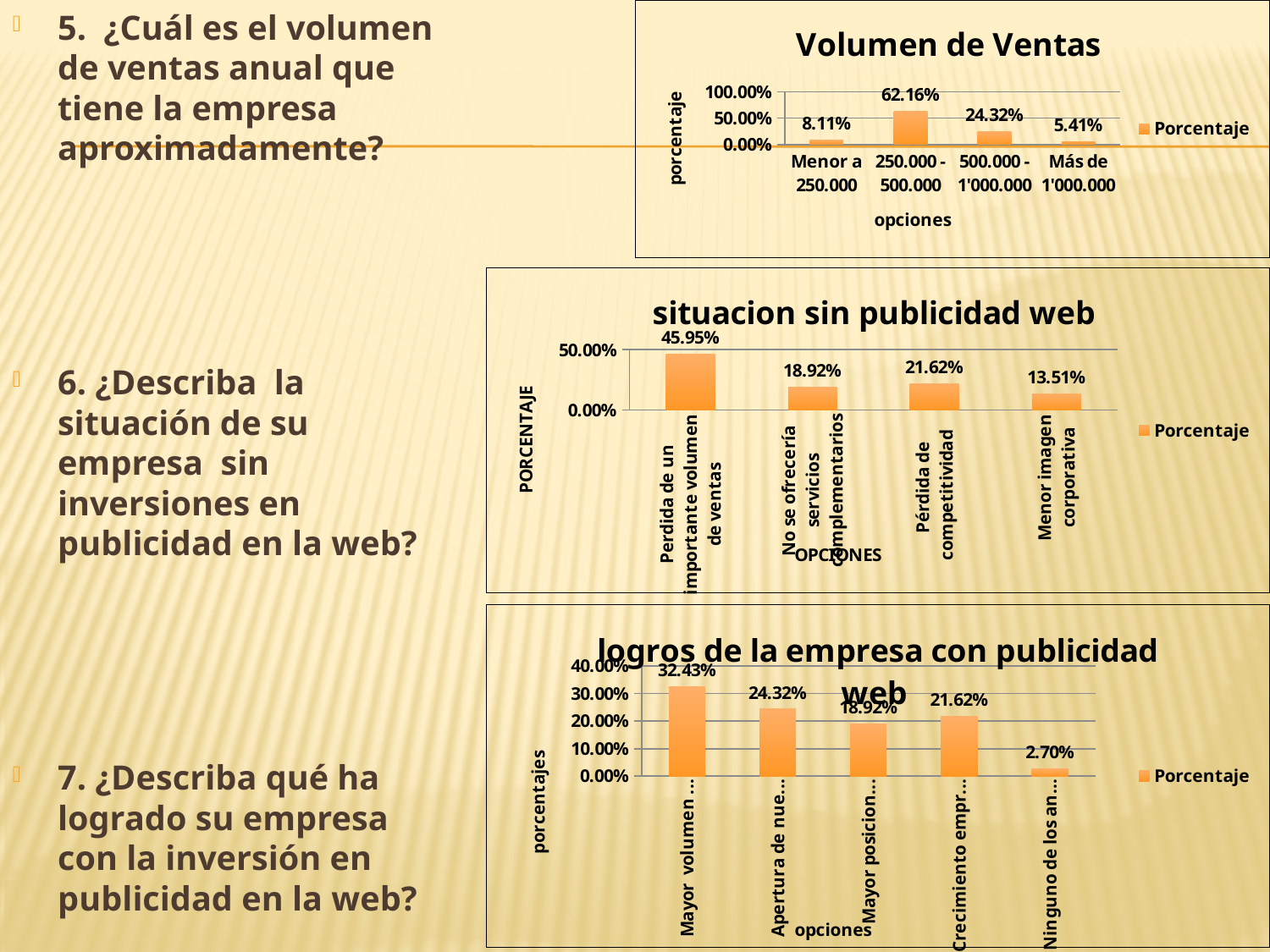
In the 'Volumen de Ventas' chart, what is the difference between the values for '500.000 - 1'000.000' and 'Menor a 250.000'? 16.21% In the 'situacion sin publicidad web' chart, what is the value for 'Pérdida de competitividad'? 21.62% In the 'logros de la empresa con publicidad web' chart, how many series does the legend list? 1 In the 'Volumen de Ventas' chart, how many categories are shown on the x axis? 4 In the 'situacion sin publicidad web' chart, which category has the highest value? Perdida de un importante volumen de ventas In the 'situacion sin publicidad web' chart, what kind of chart is shown? Bar chart In the 'Volumen de Ventas' chart, what is the value for '250.000 - 500.000'? 62.16% In the 'logros de la empresa con publicidad web' chart, what is the value of the first bar ('Mayor volumen...')? 32.43% In the 'logros de la empresa con publicidad web' chart, what is the value of the last bar ('Ninguno de los an...')? 2.70% In the 'Volumen de Ventas' chart, which category has the lowest value? Más de 1'000.000 In the 'situacion sin publicidad web' chart, which is larger: 'No se ofrecería servicios complementarios' or 'Menor imagen corporativa'? No se ofrecería servicios complementarios In the 'logros de la empresa con publicidad web' chart, how many bars are plotted? 5